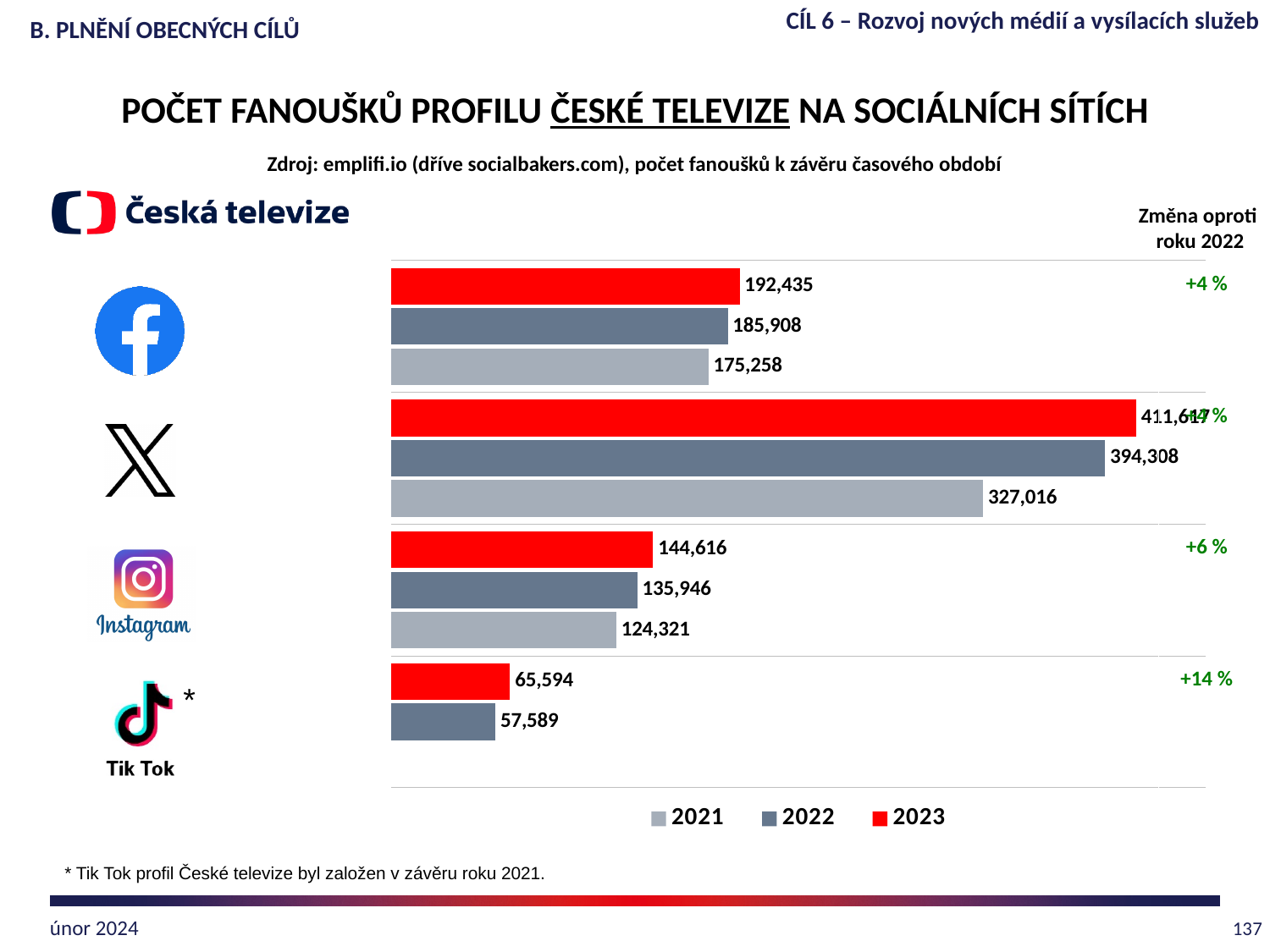
What is the difference between the 2023 and 2022 values for Facebook? 6,527 What is the 2022 value for Tik Tok? 57,589 Do the Instagram values rise or fall from 2021 to 2023? Rise What is the difference between the 2023 and 2022 values for Instagram? 8,670 How many series does the legend list? 3 Which is larger: the 2022 value for Facebook or the 2023 value for Instagram? 2022 value for Facebook What kind of chart is shown on the slide? Bar chart What is the difference between the 2023 and 2022 values for Tik Tok? 8,005 What is the change versus 2022 shown for Tik Tok? +14 % What is the 2023 value for Instagram? 144,616 What is the 2021 value for Facebook? 175,258 Which colour represents the 2023 series in the legend? Red